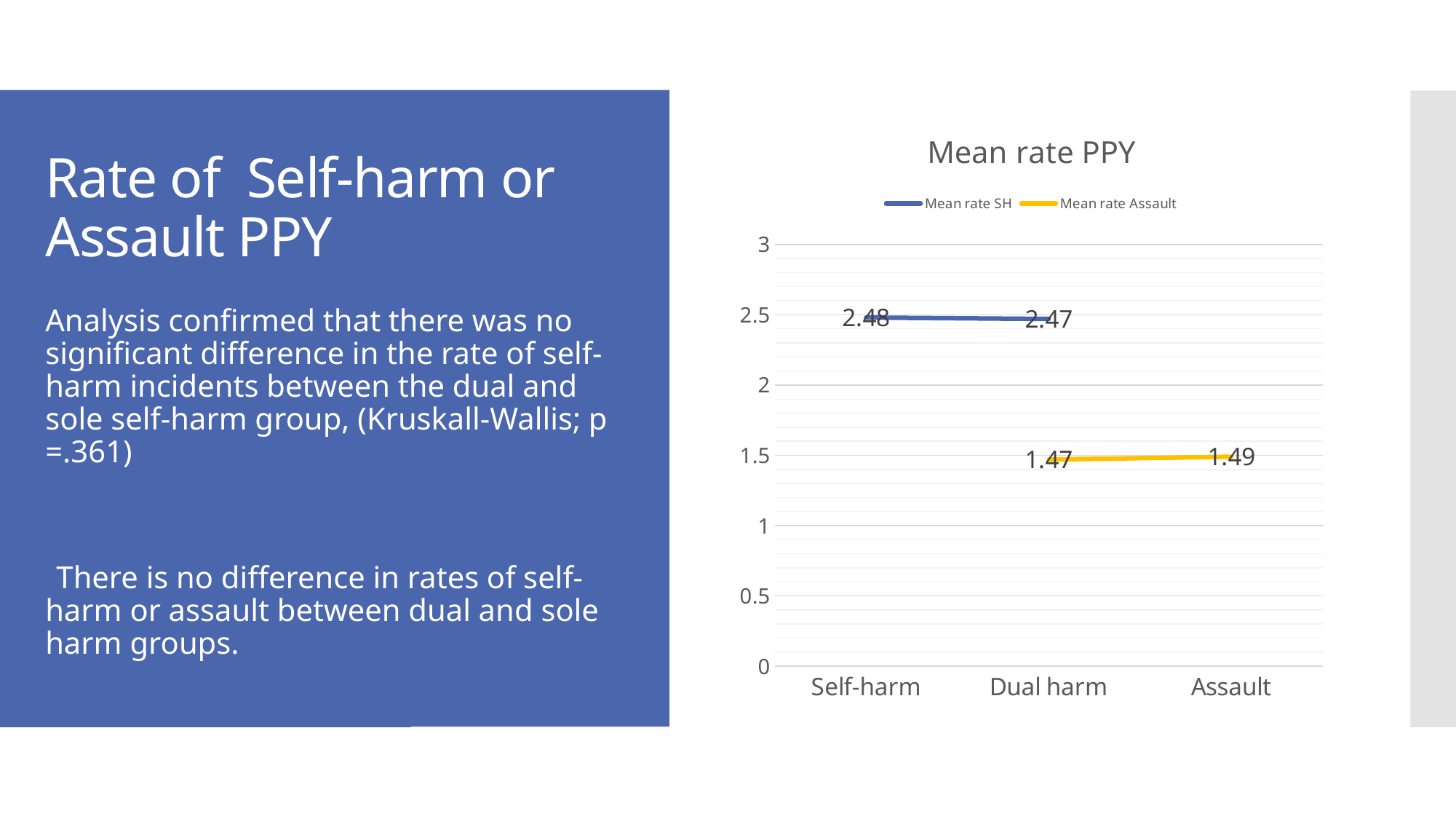
Which colour represents the Mean rate Assault series? yellow What is the Mean rate Assault value for Assault? 1.49 How many categories are shown on the x axis? 3 Is the Mean rate Assault value for Assault greater or less than 2? less What is the title of the chart? Mean rate PPY What type of chart is shown on the slide? line chart What is the Mean rate Assault value for Dual harm? 1.47 What is the difference between the Mean rate SH value for Dual harm and the Mean rate Assault value for Dual harm? 1 How many series does the legend list? 2 What is the Mean rate SH value for Self-harm? 2.48 Which is larger for Dual harm: Mean rate SH or Mean rate Assault? Mean rate SH What is the Mean rate SH value for Dual harm? 2.47